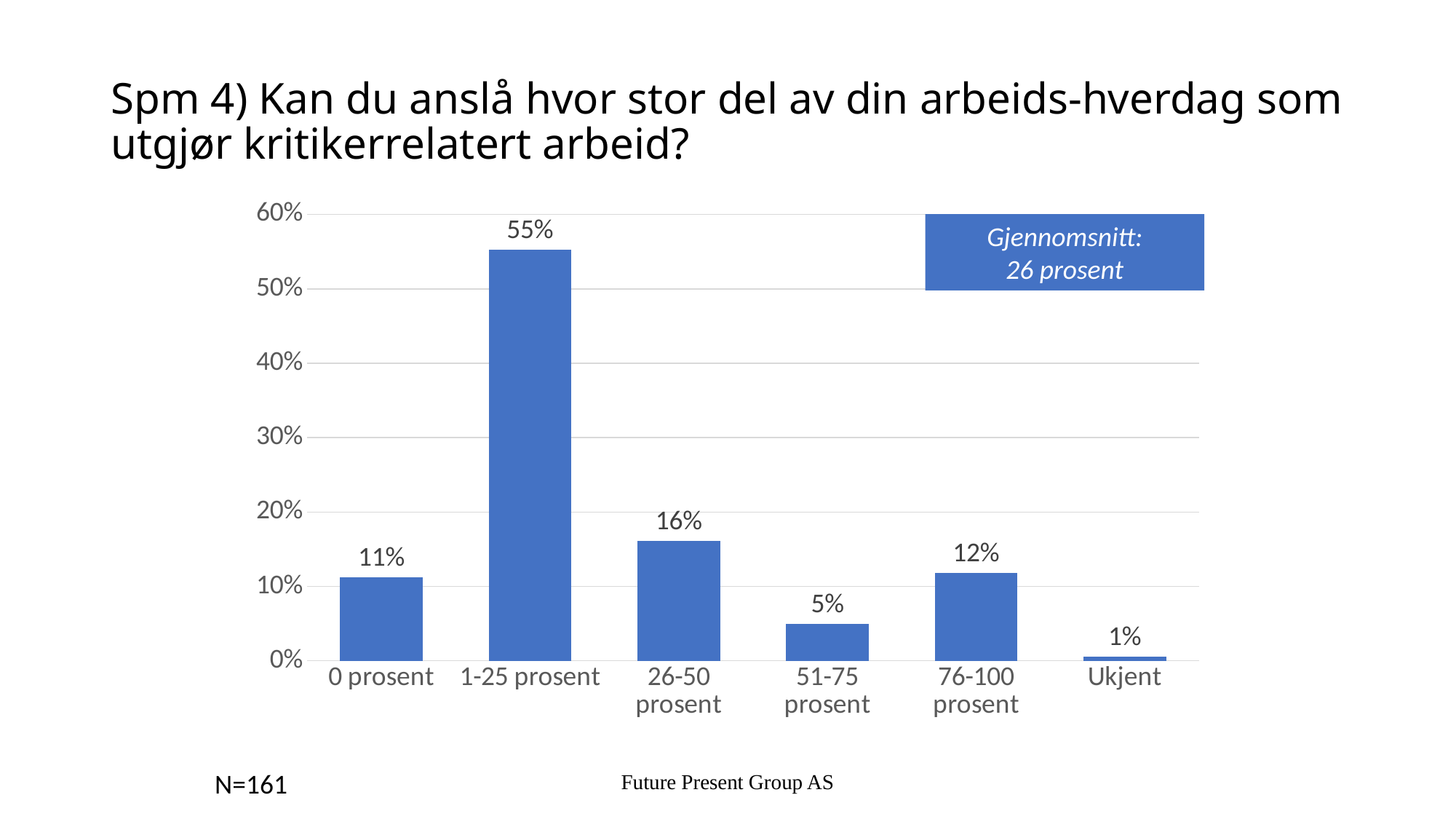
Which category has the highest value? 1-25 prosent Which category has the lowest value? Ukjent What is the value for the 'Ukjent' category? 1% What is the value for the '1-25 prosent' category? 55% What sample size (N) is shown on the slide? N=161 What is the value for the '76-100 prosent' category? 12% Is the value for '26-50 prosent' greater or less than 20%? less What is the difference between the values for '1-25 prosent' and '26-50 prosent'? 39% How many categories are shown on the x axis? 6 What average (Gjennomsnitt) is stated in the box on the chart? 26 prosent What kind of chart is shown on the slide? bar chart Which is larger, the value for '0 prosent' or the value for '76-100 prosent'? 76-100 prosent